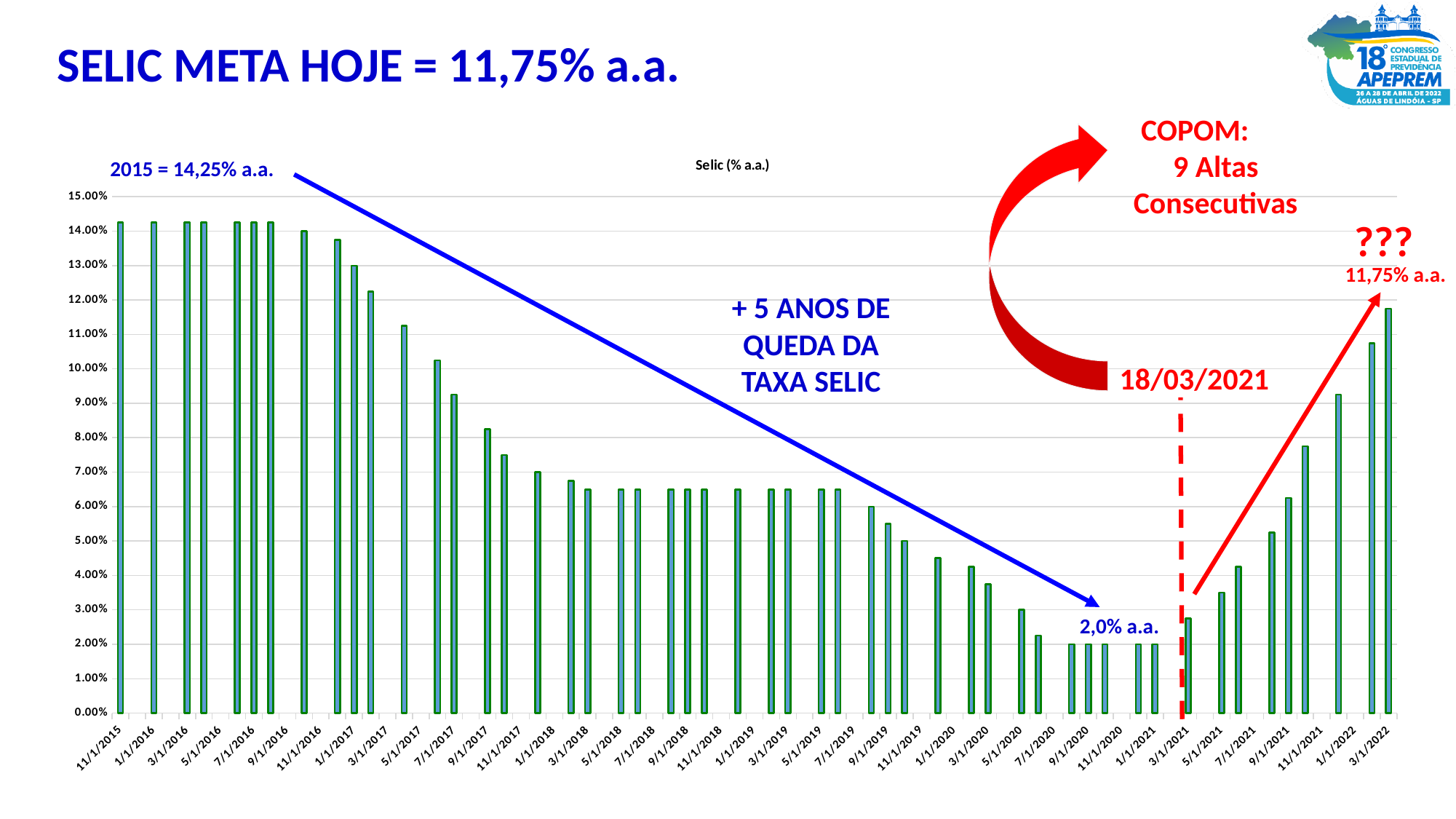
What date is marked by the red dashed vertical line on the chart? 18/03/2021 Is the value for 3/1/2022 greater or less than 11.00%? greater Is the value for 1/1/2017 greater or less than 12.00%? greater According to the annotation on the chart, what is the Selic rate for the last bar (3/1/2022)? 11,75% a.a. Do the values rise or fall from 11/1/2015 to 9/1/2020? fall What is the title of the chart? Selic (% a.a.) What kind of chart is shown on the slide? bar chart Is the value for 9/1/2020 greater or less than 3.00%? less According to the annotation on the chart, what was the Selic rate in 2015? 14,25% a.a. According to the annotation on the chart, what is the lowest Selic rate reached in 2020–2021? 2,0% a.a. Which is larger, the value for 11/1/2015 or the value for 3/1/2022? 11/1/2015